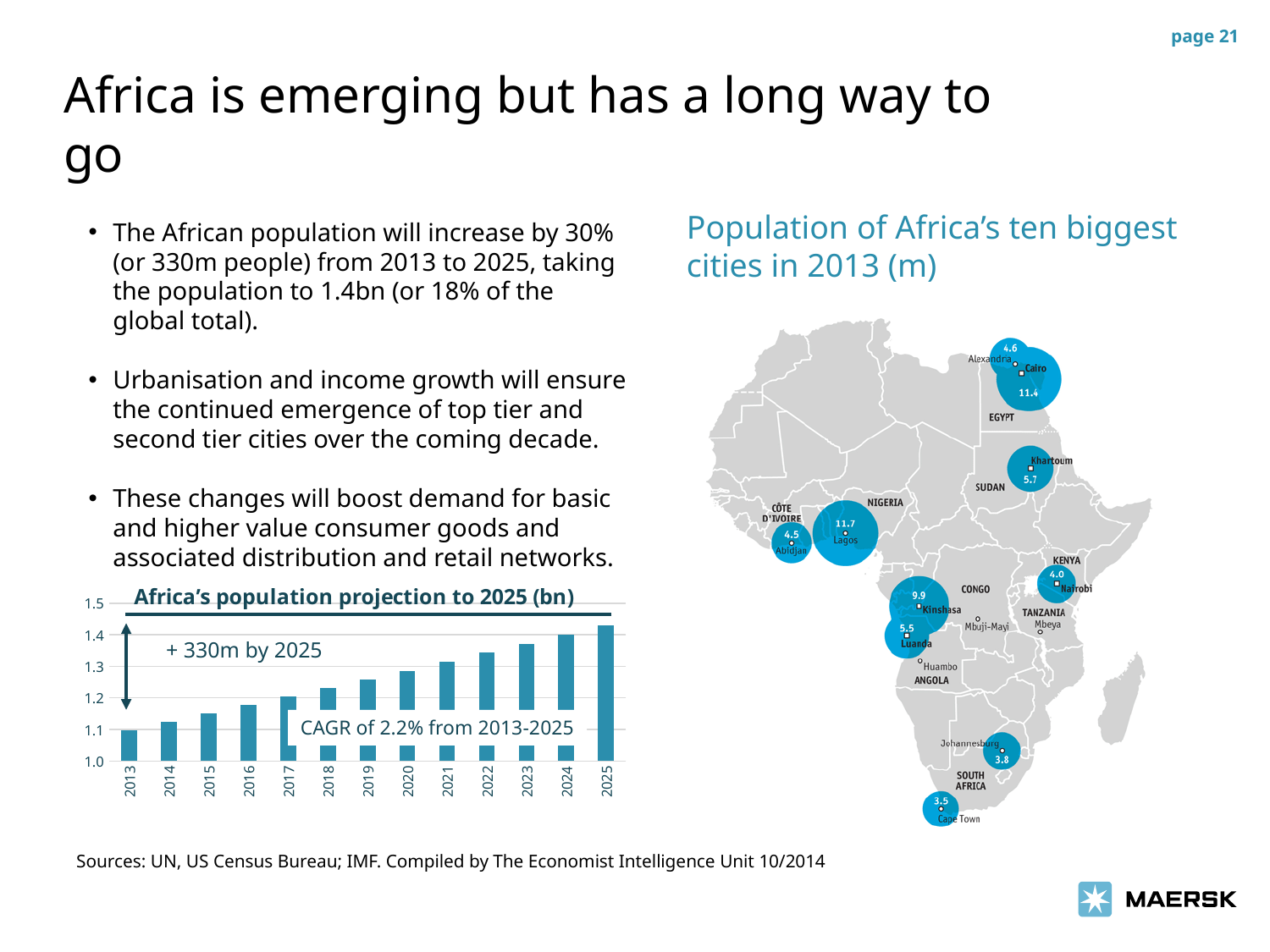
In the 'Africa's population projection to 2025 (bn)' chart, is the value for 2023 greater or less than 1.3? greater In the 'Africa's population projection to 2025 (bn)' chart, how many years are plotted? 13 In the 'Africa's population projection to 2025 (bn)' chart, which year has the highest bar? 2025 In the 'Africa's population projection to 2025 (bn)' chart, do the values rise or fall from 2013 to 2025? rise In the map chart 'Population of Africa's ten biggest cities in 2013 (m)', what is the difference between the populations of Lagos and Cairo? 0.3 In the map chart 'Population of Africa's ten biggest cities in 2013 (m)', which city has the largest population? Lagos In the 'Africa's population projection to 2025 (bn)' chart, which year has the lowest bar? 2013 In the 'Africa's population projection to 2025 (bn)' chart, is the value for 2025 greater or less than 1.4? greater What type of chart is 'Africa's population projection to 2025 (bn)'? bar chart In the map chart 'Population of Africa's ten biggest cities in 2013 (m)', what is the population shown for Cairo? 11.4 In the 'Africa's population projection to 2025 (bn)' chart, is the value for 2013 greater or less than 1.2? less In the map chart 'Population of Africa's ten biggest cities in 2013 (m)', which city has the smallest population shown? Cape Town